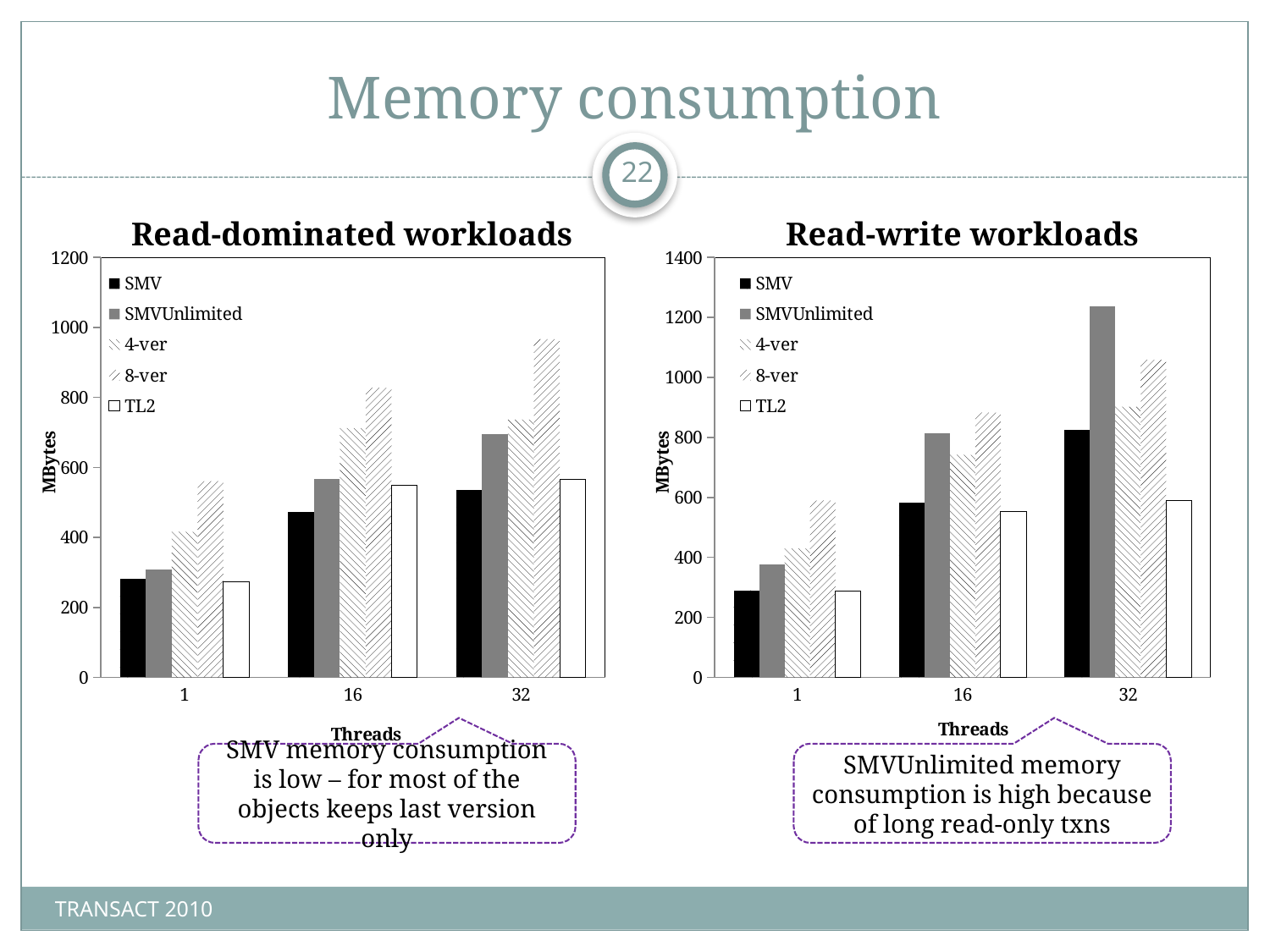
In the Read-dominated workloads chart, does the SMV value rise or fall as the number of threads increases? rises How many series does the legend of the Read-dominated workloads chart list? 5 In the Read-dominated workloads chart, which series has the highest value at 32 threads? 8-ver What kind of chart is the Read-dominated workloads chart? bar chart In the Read-write workloads chart, which series has the lowest value at 32 threads? TL2 In the Read-dominated workloads chart, is the value for SMV at 1 thread greater or less than 400? less What is the y-axis label on the Read-write workloads chart? MBytes In the Read-write workloads chart, which series has the highest value at 32 threads? SMVUnlimited In the Read-write workloads chart, is the value for SMVUnlimited at 32 threads greater or less than 1000? greater How many thread counts are shown on the x axis of the Read-write workloads chart? 3 In the Read-write workloads chart, at 16 threads, which is larger: SMVUnlimited or TL2? SMVUnlimited In the Read-dominated workloads chart, is the value for 8-ver at 32 threads greater or less than 800? greater